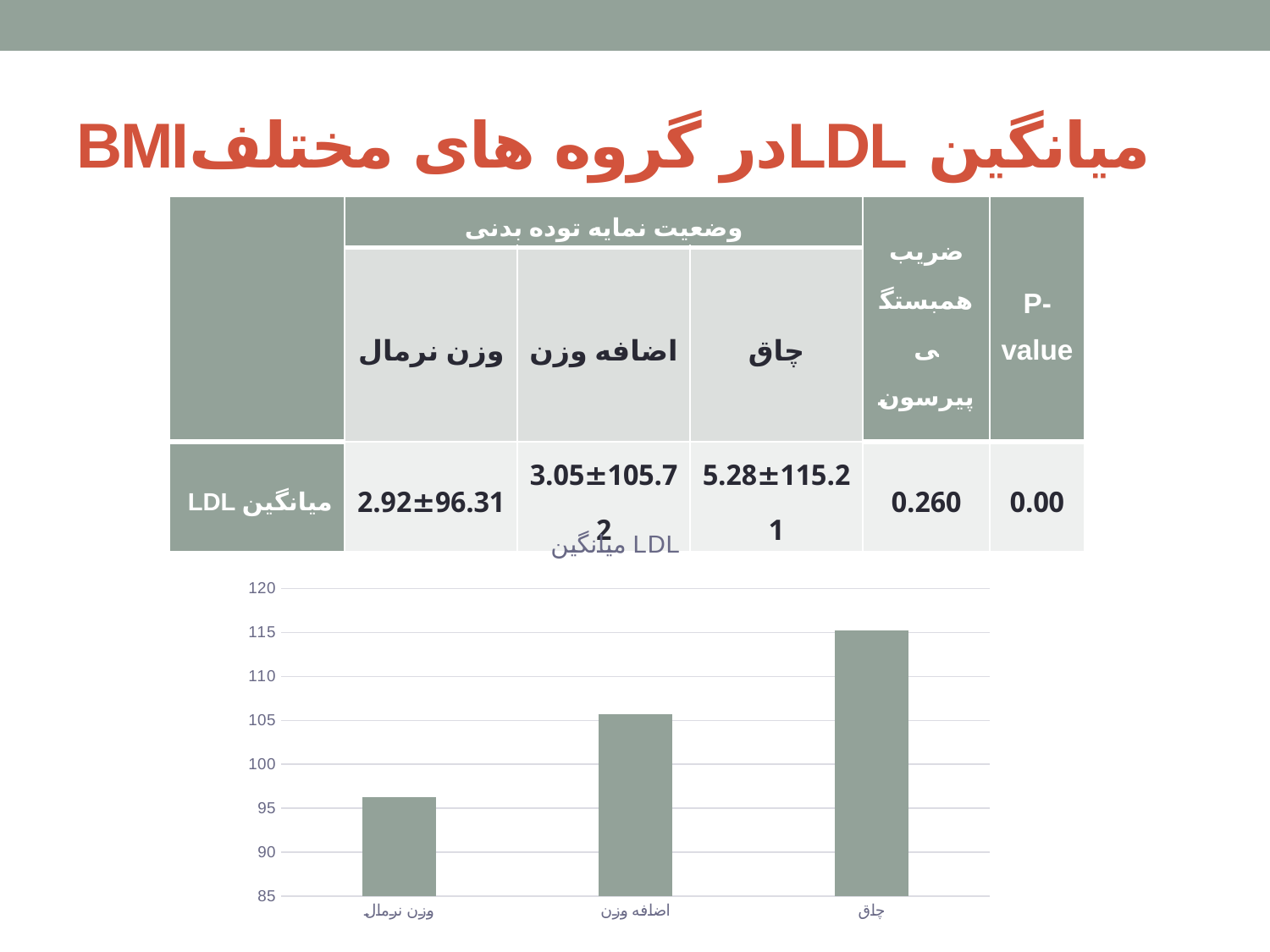
Is the value for چاق greater or less than 110? greater How many categories (bars) does the chart show? 3 Which is larger in the chart, the value for اضافه وزن or the value for وزن نرمال? اضافه وزن Which category has the highest bar in the chart? چاق Is the value for اضافه وزن greater or less than 100? greater Which category has the lowest bar in the chart? وزن نرمال Is the value for اضافه وزن greater or less than 110? less Do the bar values rise or fall moving from وزن نرمال to چاق along the x axis? rise What kind of chart is shown on the slide? bar chart What is the title of the chart? میانگین LDL